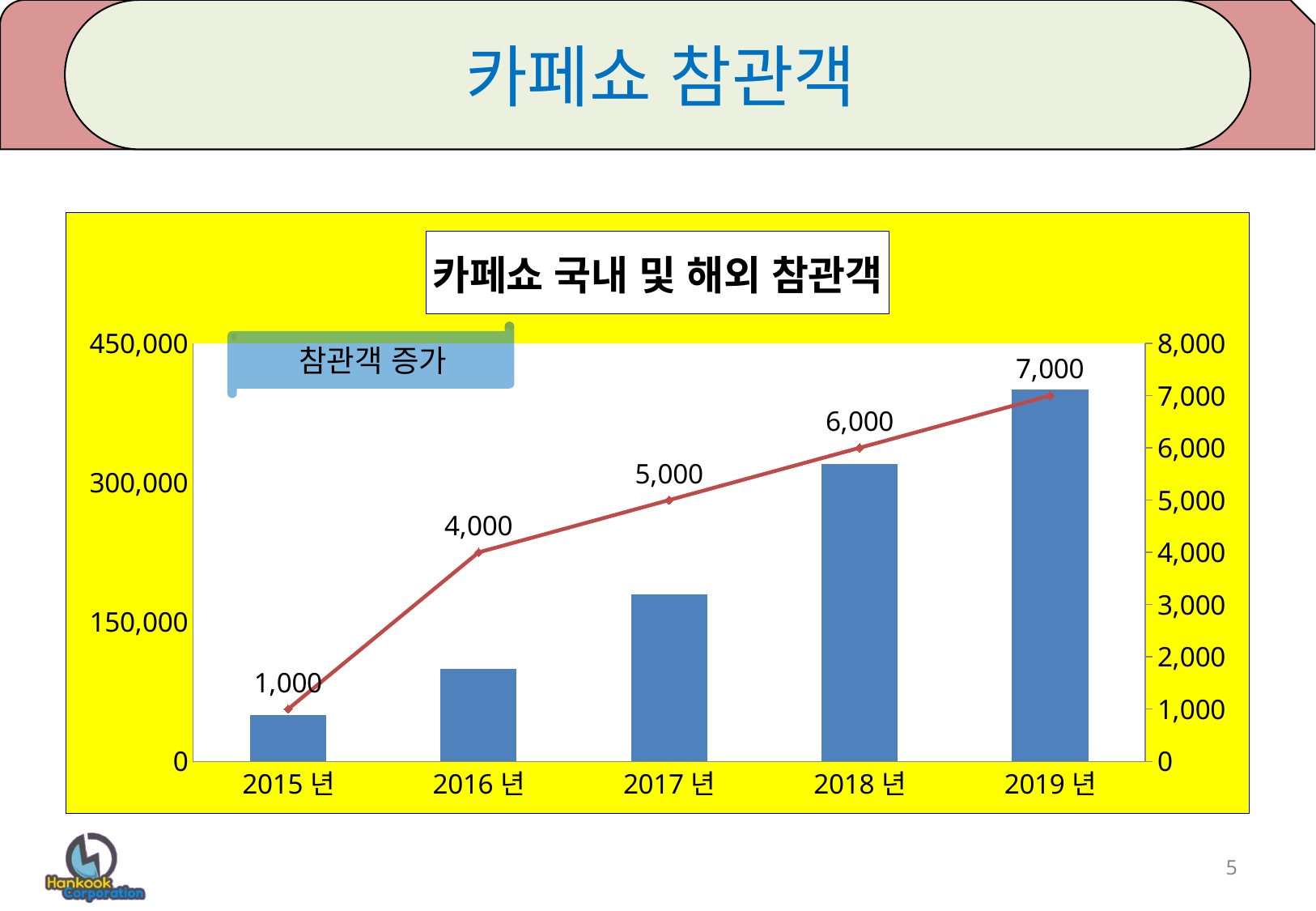
What is the value of the line series for 2015 년? 1,000 What is the difference between the line values for 2016 년 and 2015 년? 3,000 In which year does the line series reach its highest value? 2019 년 Which is larger, the line value for 2018 년 or for 2017 년? 2018 년 Is the bar value for 2016 년 greater or less than 150,000? less Is the bar value for 2019 년 greater or less than 300,000? greater In which year does the line series have its lowest value? 2015 년 What is the title of the chart? 카페쇼 국내 및 해외 참관객 What is the value of the line series for 2019 년? 7,000 What is the value of the line series for 2017 년? 5,000 Do the bar values rise or fall from 2015 년 to 2019 년? rise How many years are shown on the x axis? 5